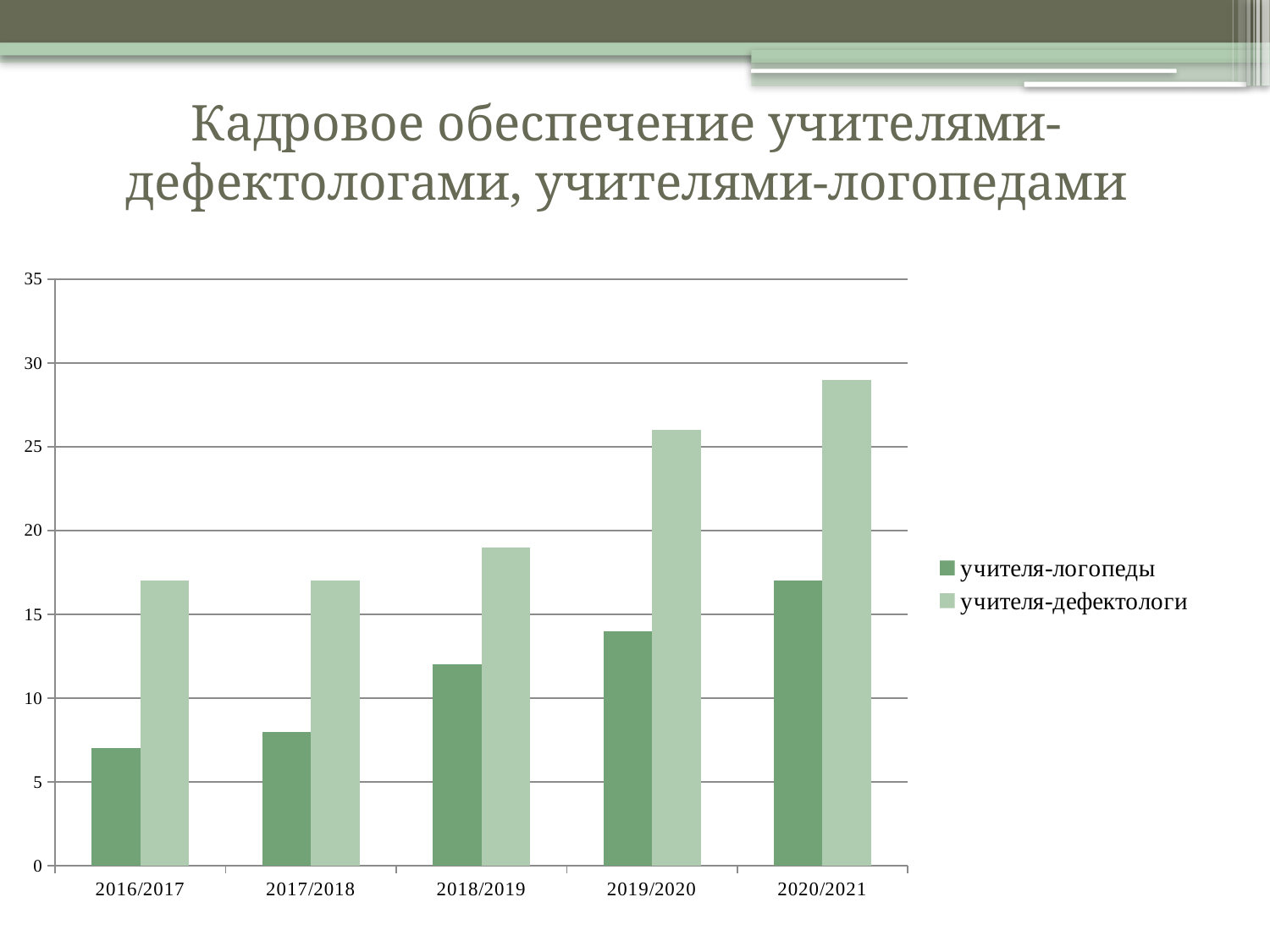
Is the value for учителя-дефектологи in 2020/2021 greater or less than 25? greater In 2019/2020, which series has the larger value: учителя-логопеды or учителя-дефектологи? учителя-дефектологи Which series is shown in the darker green colour in the chart? учителя-логопеды Is the value for учителя-логопеды in 2016/2017 greater or less than 10? less Is the value for учителя-логопеды in 2020/2021 greater or less than 15? greater What kind of chart is shown on the slide? bar chart Which academic year has the lowest value for учителя-логопеды? 2016/2017 How many series does the chart's legend list? 2 How many academic years are shown on the x axis of the chart? 5 Which academic year has the highest value for учителя-дефектологи? 2020/2021 Do the values for учителя-логопеды rise or fall from 2016/2017 to 2020/2021? rise